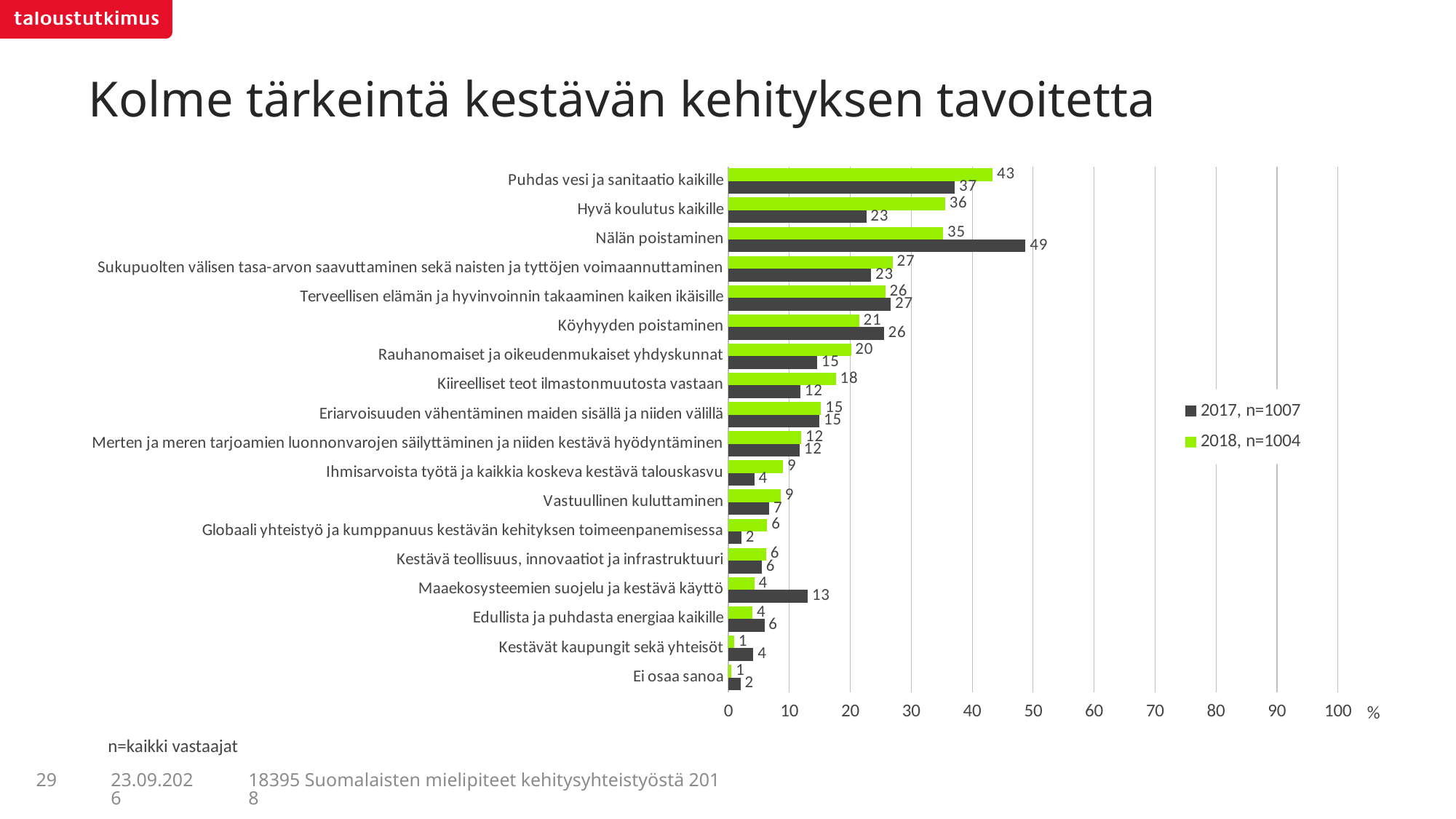
Which legend entry is shown in green? 2018, n=1004 What is the difference between the 2018 and 2017 values for Hyvä koulutus kaikille? 13 What kind of chart is shown on the slide? bar chart What is the 2018 value for Kiireelliset teot ilmastonmuutosta vastaan? 18 What is the 2017 value for Maaekosysteemien suojelu ja kestävä käyttö? 13 What is the 2017 value for Nälän poistaminen? 49 Which category has the highest 2018 value? Puhdas vesi ja sanitaatio kaikille What is the 2018 value for Puhdas vesi ja sanitaatio kaikille? 43 Which category has the highest 2017 value? Nälän poistaminen How many categories are shown on the chart? 18 How many series does the legend list? 2 Which is larger for Köyhyyden poistaminen, the 2017 value or the 2018 value? 2017